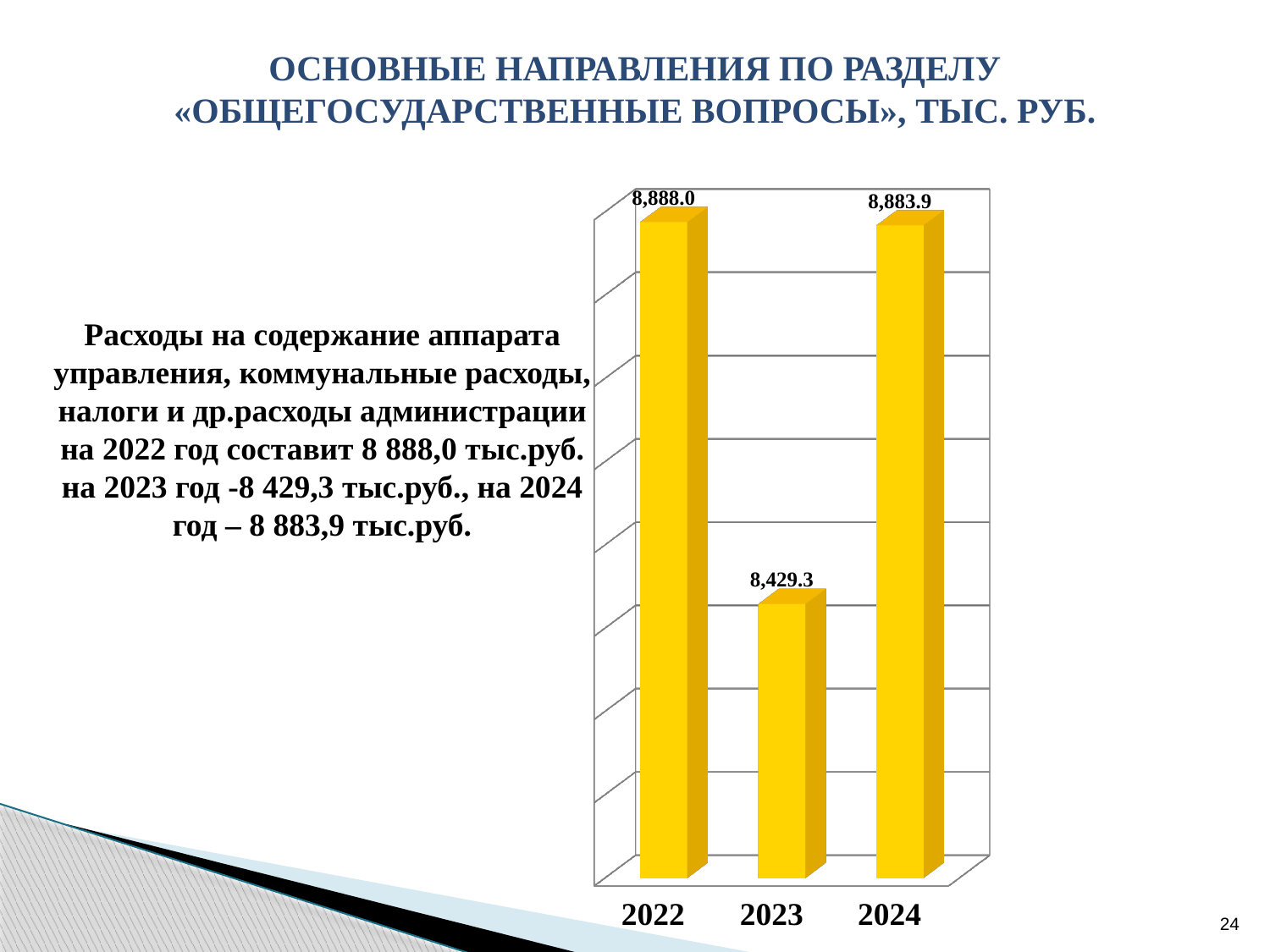
Which is larger, the value for 2023 or the value for 2024? 2024 What is the value for 2022? 8,888.0 How many years are shown on the chart? 3 What kind of chart is shown on the slide? Bar chart What is the difference between the values for 2022 and 2023? 458.7 Does the value rise or fall from 2022 to 2023? Fall What is the value for 2024? 8,883.9 Which year has the lowest value? 2023 What is the value for 2023? 8,429.3 What is the difference between the values for 2024 and 2023? 454.6 What is the difference between the values for 2022 and 2024? 4.1 Which year has the highest value? 2022